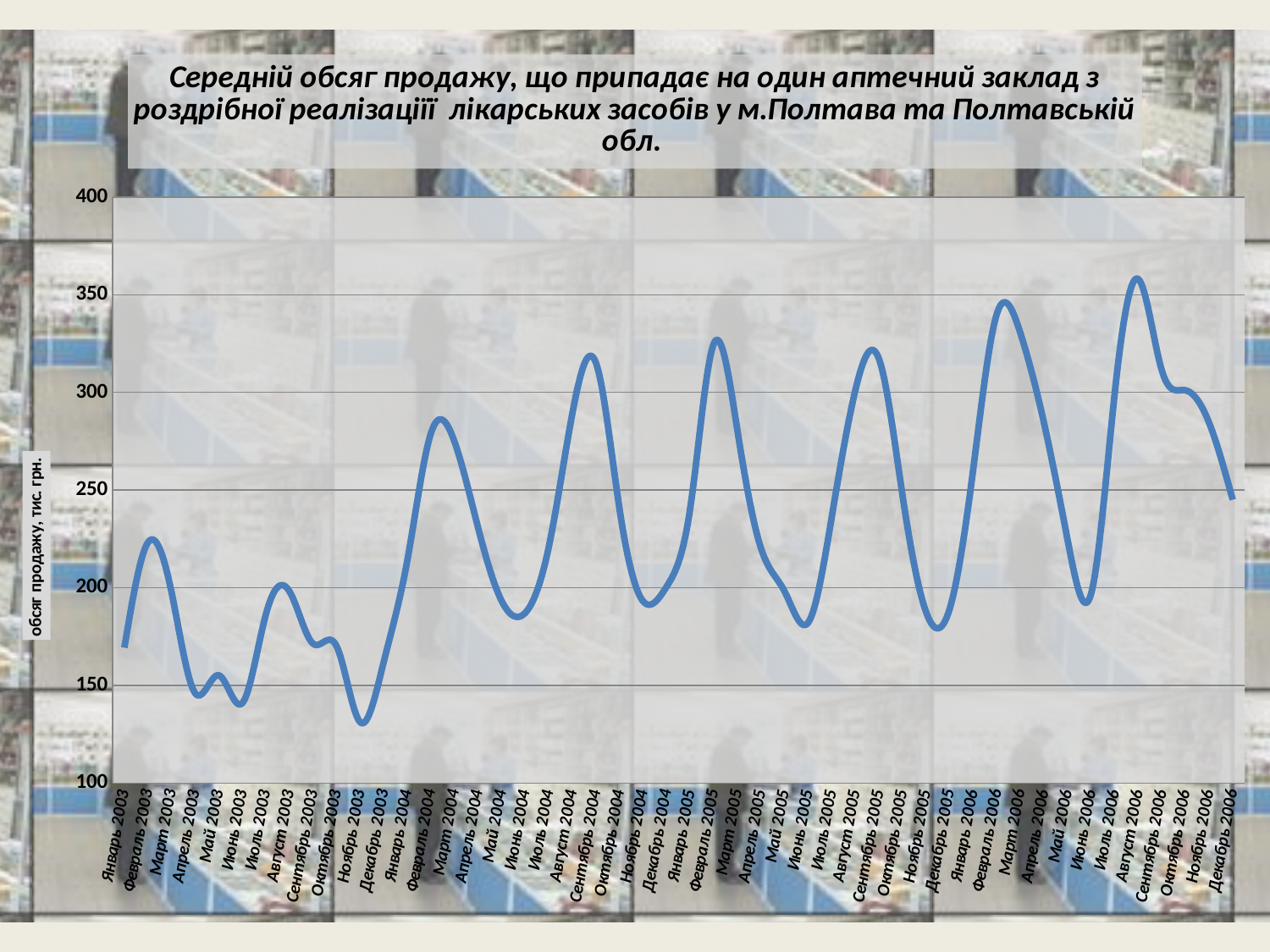
Is the value for Март 2005 greater or less than 300? less In which month is the plotted value lowest? Ноябрь 2003 Is the value for Август 2006 greater or less than 350? greater What is the label on the vertical axis of the chart? обсяг продажу, тис. грн. Do the seasonal peaks of the line generally rise or fall from 2003 to 2006? rise In which month is the plotted value highest? Август 2006 Is the value for Ноябрь 2003 greater or less than 150? less What kind of chart is shown on the slide? line chart Which is larger, the value for Март 2006 or the value for Март 2004? Март 2006 How many monthly data points are plotted on the chart? 48